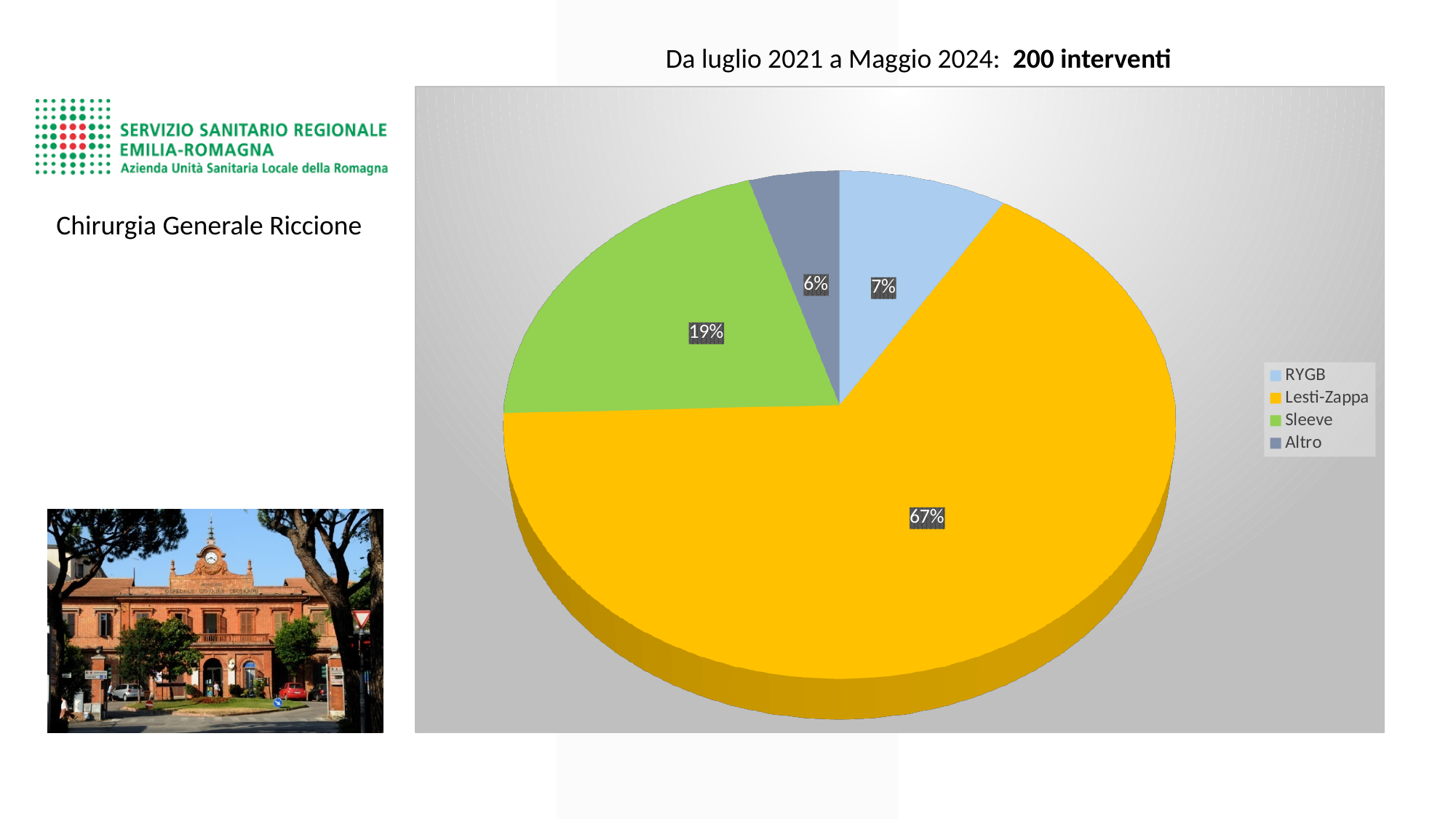
What colour is the Sleeve slice in the pie chart? green According to the text above the chart, how many interventions does the chart cover? 200 interventi What percentage of the pie does Sleeve account for? 19% Which slice is larger, Sleeve or RYGB? Sleeve Which category has the largest slice of the pie? Lesti-Zappa What percentage of the pie does Lesti-Zappa account for? 67% What percentage of the pie does Altro account for? 6% Which category has the smallest slice of the pie? Altro What percentage of the pie does RYGB account for? 7% How many categories does the pie chart show? 4 What kind of chart is shown on the slide? pie chart What is the difference in percentage points between the Lesti-Zappa and Sleeve slices? 48